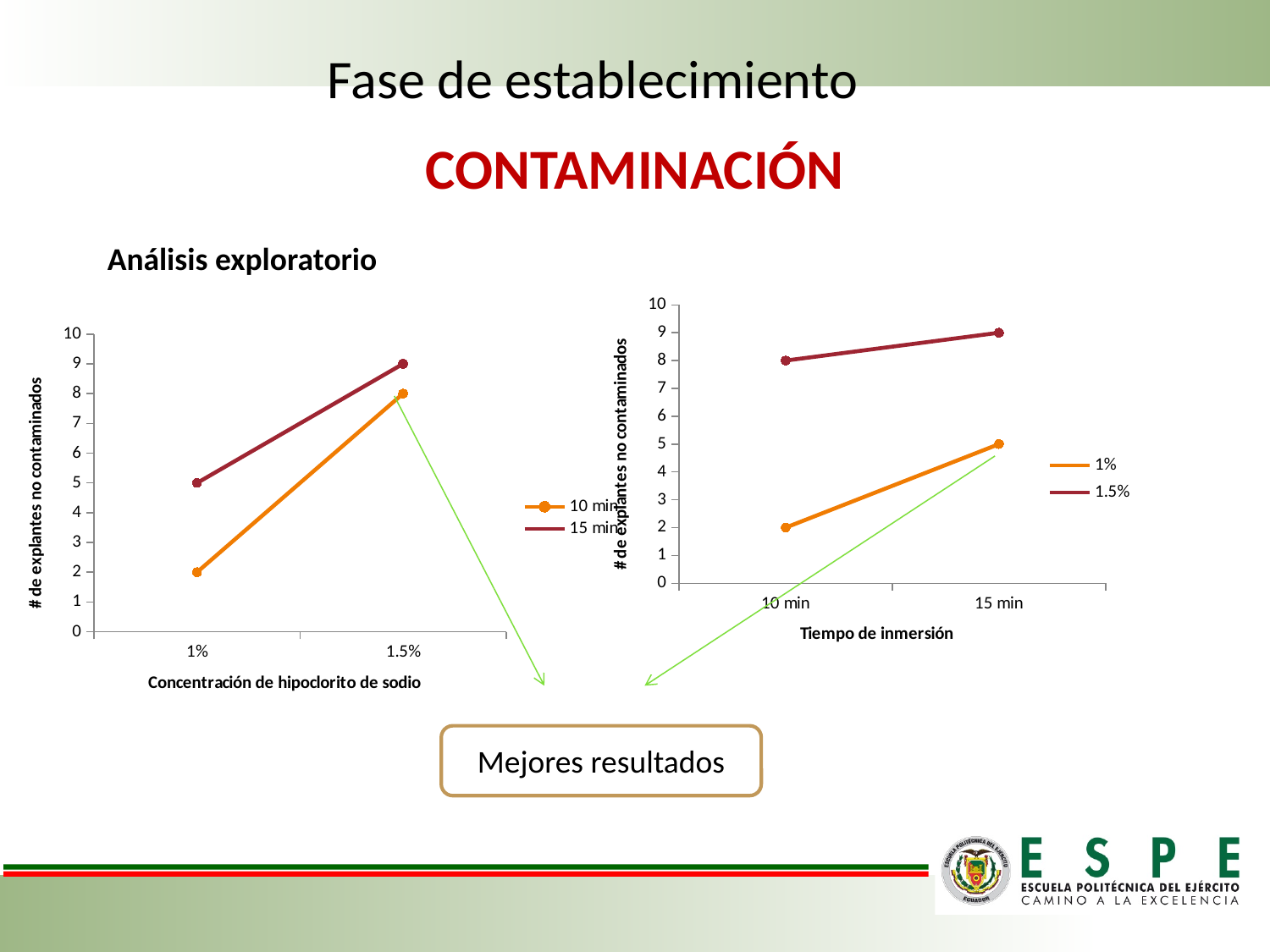
In the right chart (Tiempo de inmersión), what is the difference between the 1.5% and 1% values at 15 min? 4 In the left chart (Concentración de hipoclorito de sodio), what is the value of the 10 min series at 1%? 2 In the right chart (Tiempo de inmersión), how many categories are on the x axis? 2 In the right chart (Tiempo de inmersión), what is the value of the 1% series at 15 min? 5 What kind of chart is the left chart (Concentración de hipoclorito de sodio)? line chart In the left chart (Concentración de hipoclorito de sodio), how many series does the legend list? 2 In the left chart (Concentración de hipoclorito de sodio), does the 10 min series rise or fall from 1% to 1.5%? rise In the left chart (Concentración de hipoclorito de sodio), which series has the higher value at 1.5%? 15 min In the left chart (Concentración de hipoclorito de sodio), what is the difference between the 15 min and 10 min values at 1%? 3 In the right chart (Tiempo de inmersión), what is the value of the 1.5% series at 10 min? 8 In the left chart (Concentración de hipoclorito de sodio), what is the value of the 15 min series at 1.5%? 9 What is the y-axis title of the right chart (Tiempo de inmersión)? # de explantes no contaminados